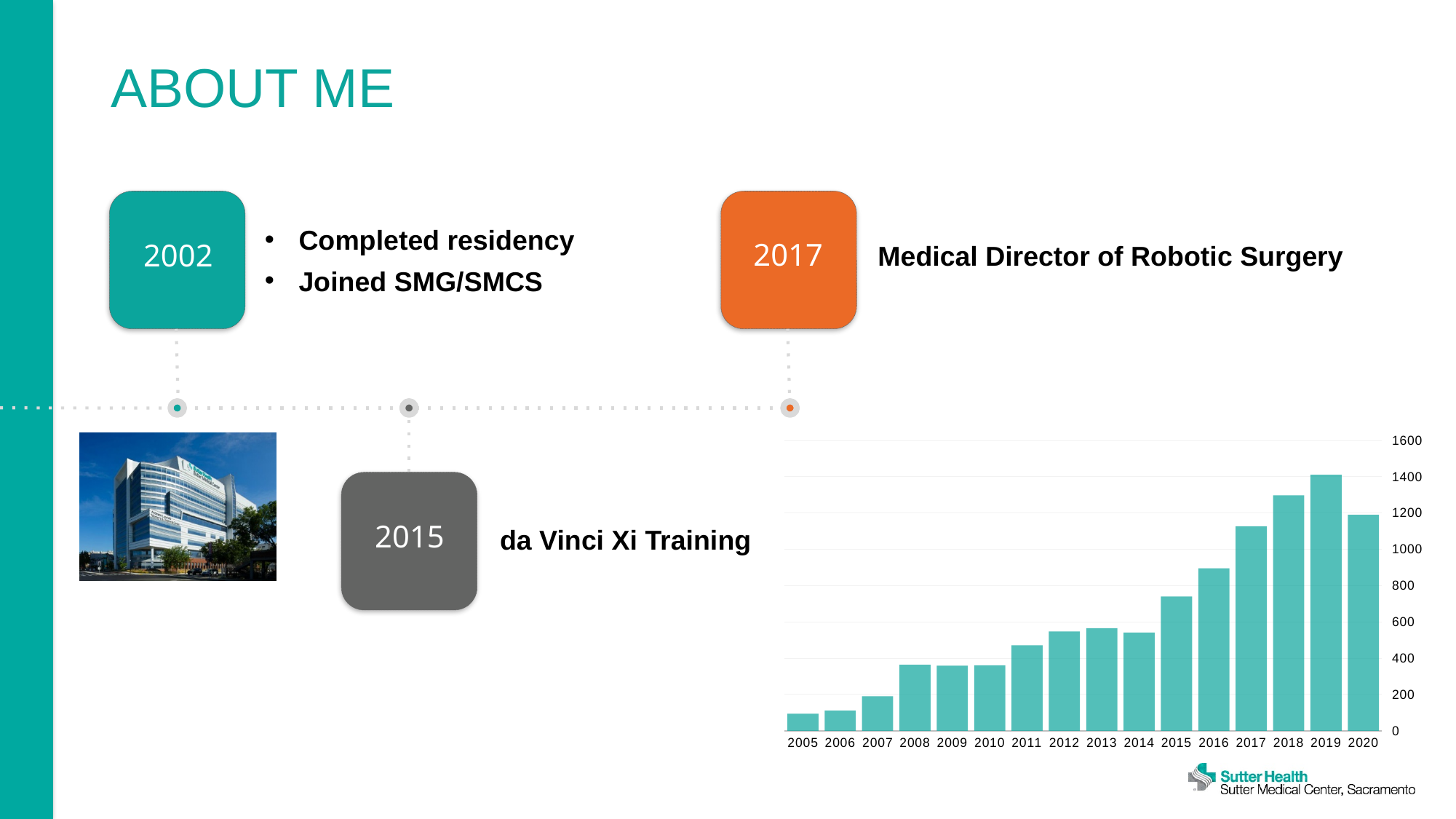
Is the value for 2019 greater or less than 1200? greater Which year has the tallest bar in the chart? 2019 Is the value for 2017 greater or less than 1000? greater Which bar is taller, 2011 or 2012? 2012 What kind of chart is shown at the bottom right of the slide? bar chart What is the highest value shown on the chart's vertical axis? 1600 Is the value for 2015 greater or less than 800? less How many years are shown on the x axis of the bar chart? 16 Which bar is taller, 2018 or 2020? 2018 Do the bar values generally rise or fall from 2005 to 2019? rise